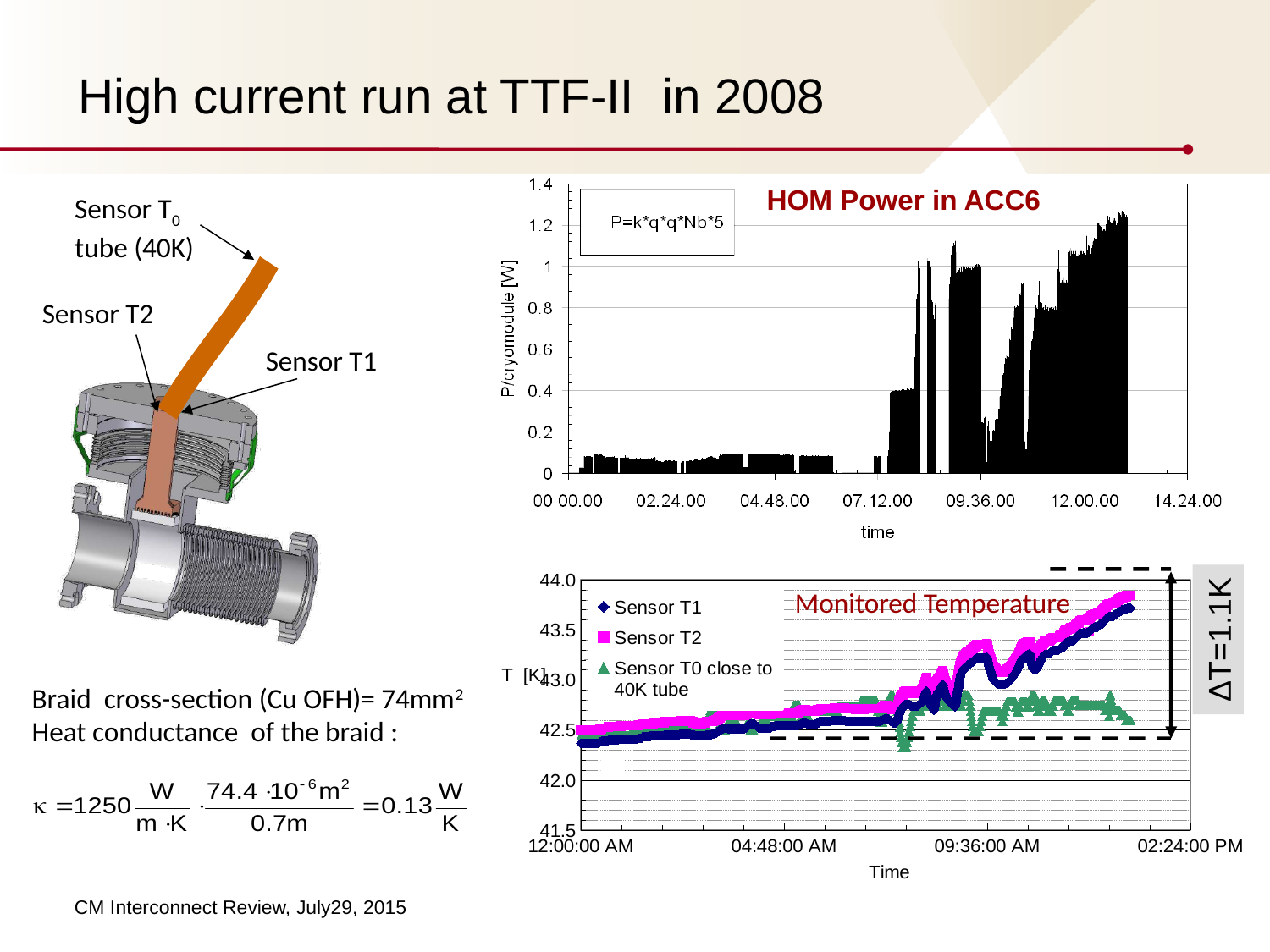
On the Monitored Temperature chart, at the end of the run, which is higher: Sensor T1 or Sensor T2? Sensor T2 On the HOM Power in ACC6 chart, what is the last time tick shown on the x axis? 14:24:00 What kind of chart is the Monitored Temperature chart? line chart On the HOM Power in ACC6 chart, what formula is shown in the text box? P=k*q*q*Nb*5 On the HOM Power in ACC6 chart, is the highest power value reached greater or less than 1? greater On the HOM Power in ACC6 chart, is the power before 07:12:00 greater or less than 0.2? less On the Monitored Temperature chart, what is the temperature difference indicated by the annotation on the right? ΔT=1.1K On the Monitored Temperature chart, how many series does the legend list? 3 On the Monitored Temperature chart, do the Sensor T2 values rise or fall over time? rise On the HOM Power in ACC6 chart, what quantity is plotted on the y axis? P/cryomodule [W] On the Monitored Temperature chart, is the final value of Sensor T2 greater or less than 43.5? greater